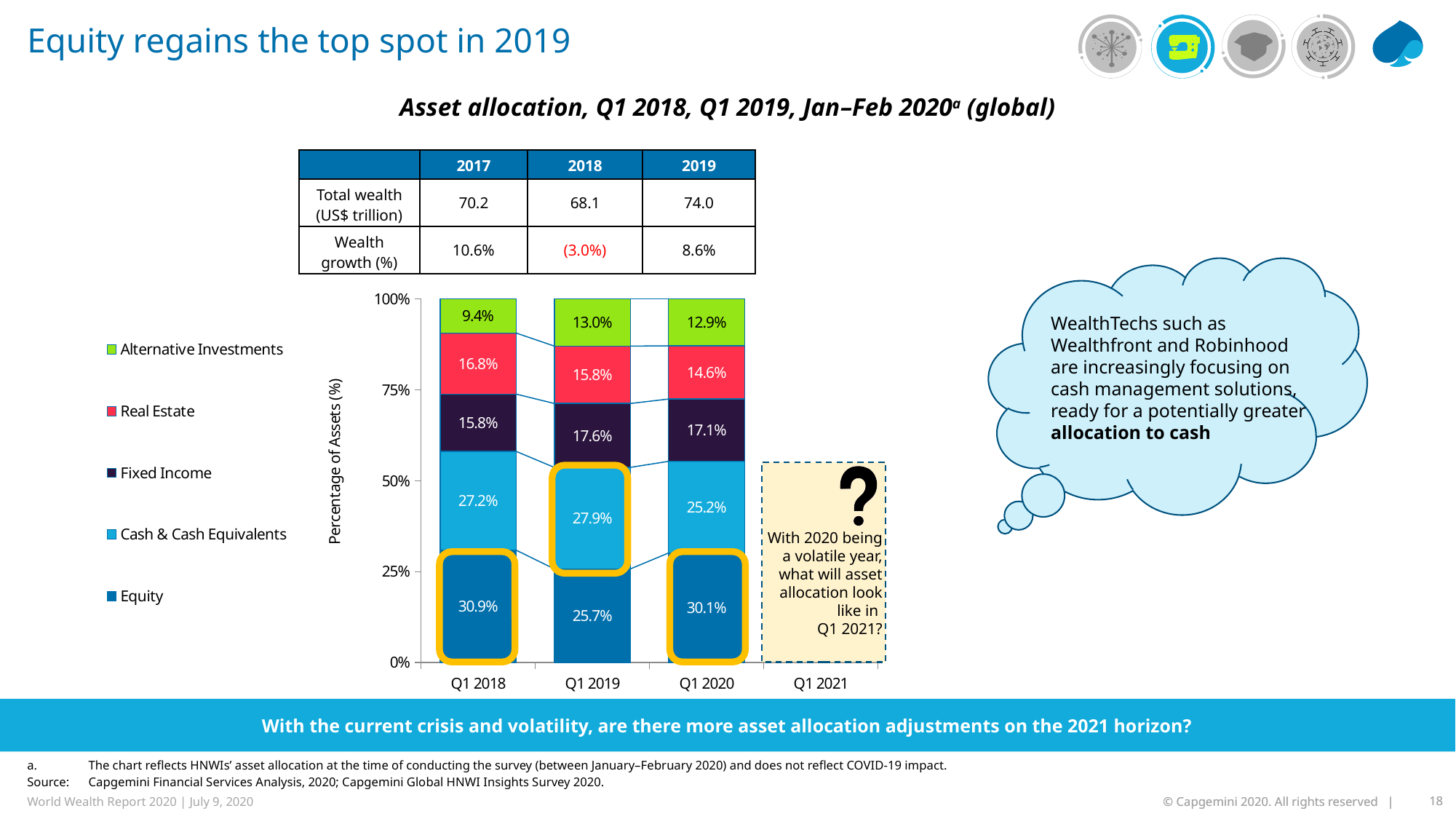
What is the Fixed Income share in Q1 2020? 17.1% How many series does the legend list? 5 Does the Real Estate share rise or fall from Q1 2018 to Q1 2020? Fall What kind of chart is shown? Stacked bar chart Which is larger: the Real Estate share in Q1 2018 or in Q1 2020? Q1 2018 Which asset class has the smallest share in Q1 2018? Alternative Investments What is the Equity share in Q1 2018? 30.9% By how many percentage points did the Equity share fall from Q1 2018 to Q1 2019? 5.2 percentage points What is the Cash & Cash Equivalents share in Q1 2019? 27.9% Which asset class has the largest share in Q1 2019? Cash & Cash Equivalents What is the label of the y axis? Percentage of Assets (%) What is the Alternative Investments share in Q1 2019? 13.0%